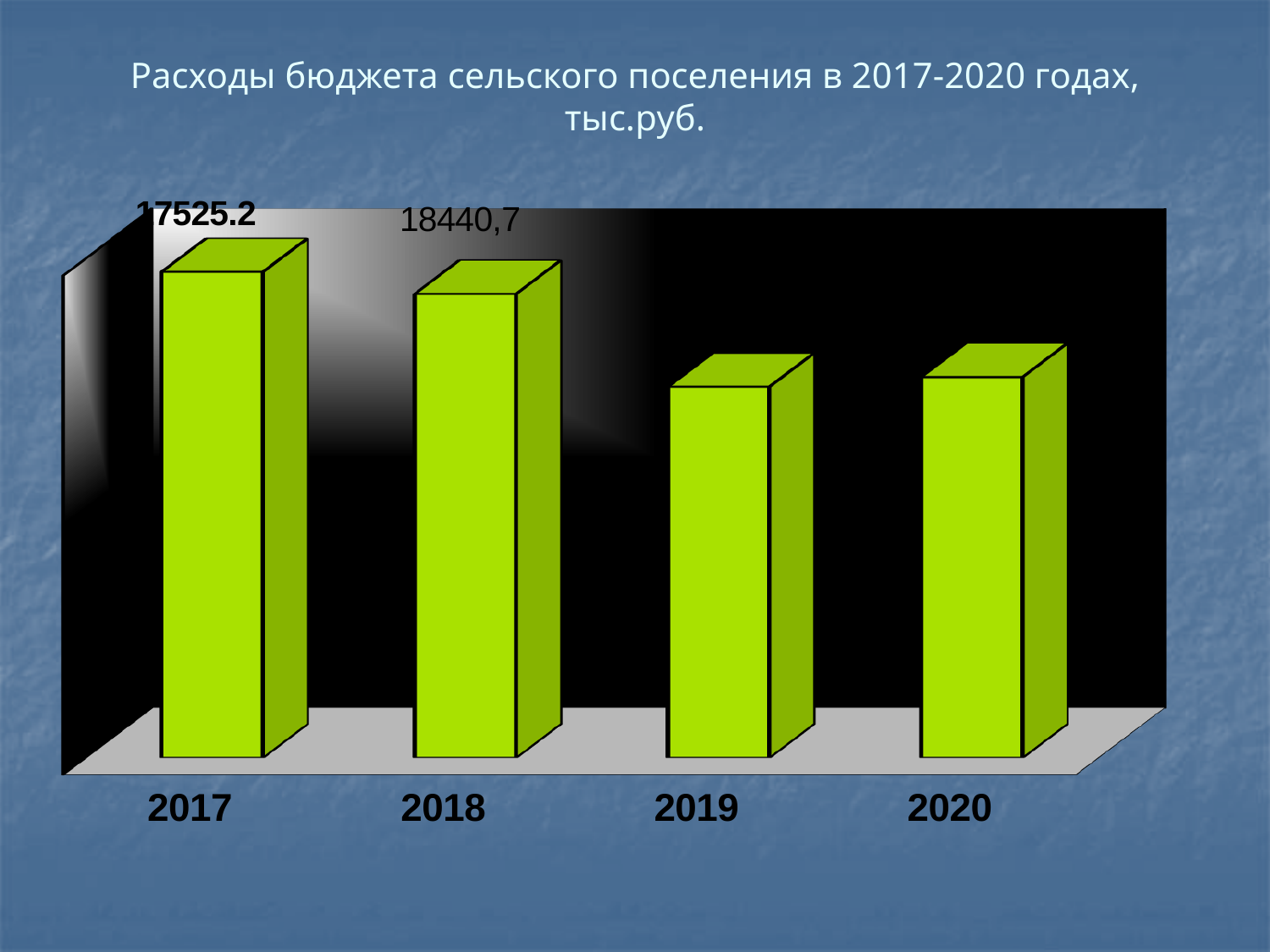
What is the title of the chart? Расходы бюджета сельского поселения в 2017-2020 годах, тыс.руб. Which year is the first category on the x axis? 2017 What kind of chart is shown on the slide? bar chart Do the bars rise or fall from 2017 to 2020 overall? fall How many years are shown on the x axis? 4 Which year is the last category on the x axis? 2020 What is the value for 2018? 18440,7 What colour are the bars in the chart? green Which bar is taller, 2017 or 2020? 2017 What is the value for 2017? 17525.2 Which bar is taller, 2017 or 2019? 2017 Which bar is taller, 2018 or 2020? 2018